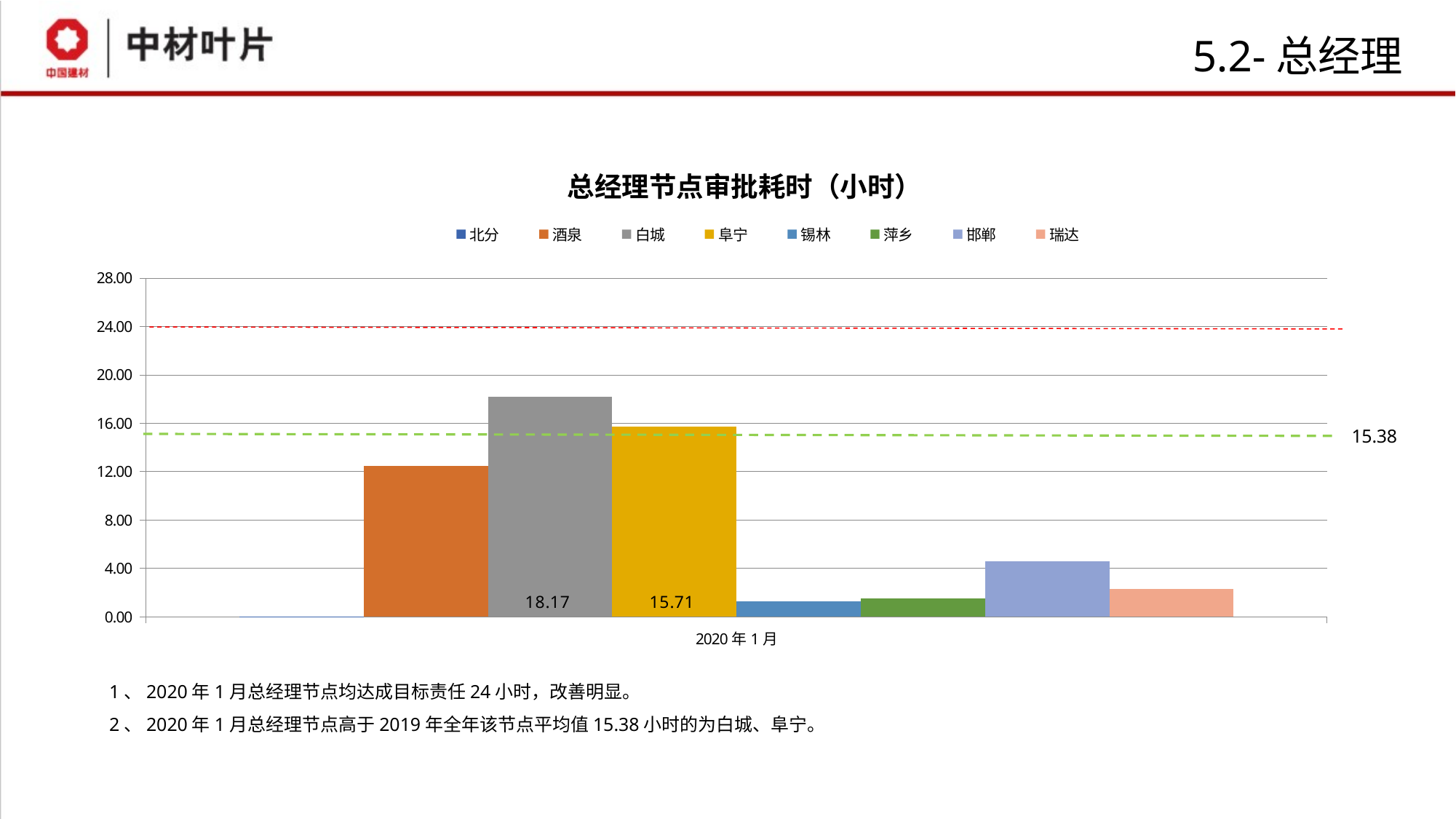
Is the value for 白城 greater or less than 24.00? less What kind of chart is shown on the slide? bar chart Which is larger, the value for 白城 or the value for 阜宁? 白城 What value is labelled on the green dashed reference line? 15.38 What is the value for 阜宁 in the chart? 15.71 Is the value for 邯郸 greater or less than 8.00? less How many series does the legend list? 8 Is the value for 酒泉 greater or less than 16.00? less Which is larger, the value for 邯郸 or the value for 瑞达? 邯郸 What is the value for 白城 in the chart? 18.17 Which series has the highest value in the chart? 白城 What is the difference between the values for 白城 and 阜宁? 2.46